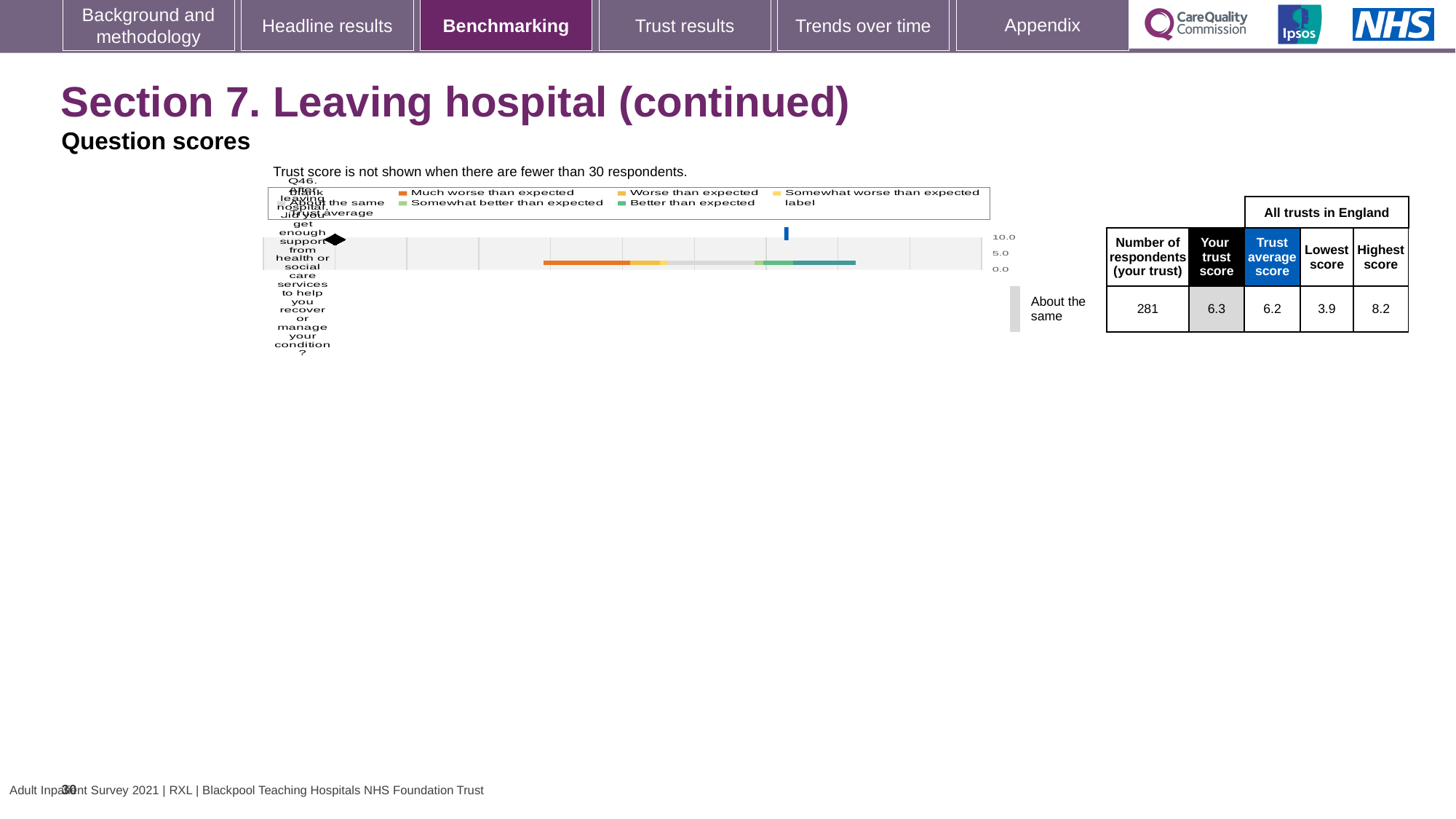
How many respondents from the trust answered Q46 according to the table? 281 What is the lowest score among all trusts in England for Q46? 3.9 What is the trust average score for Q46 across all trusts in England? 6.2 Which benchmark category is the trust's Q46 result placed in? About the same What is the difference between the highest score and the lowest score for Q46? 4.3 What kind of chart is used to show the Q46 benchmarking result? Bar chart What is the trust's score for Q46 shown in the 'Your trust score' column? 6.3 What is the highest score among all trusts in England for Q46? 8.2 Which is larger for Q46: the trust's own score or the trust average score? Your trust score Which legend category is shown in orange on the chart? Much worse than expected By how much does the trust's score for Q46 exceed the trust average score? 0.1 Is the trust's score for Q46 greater or less than 5.0? greater